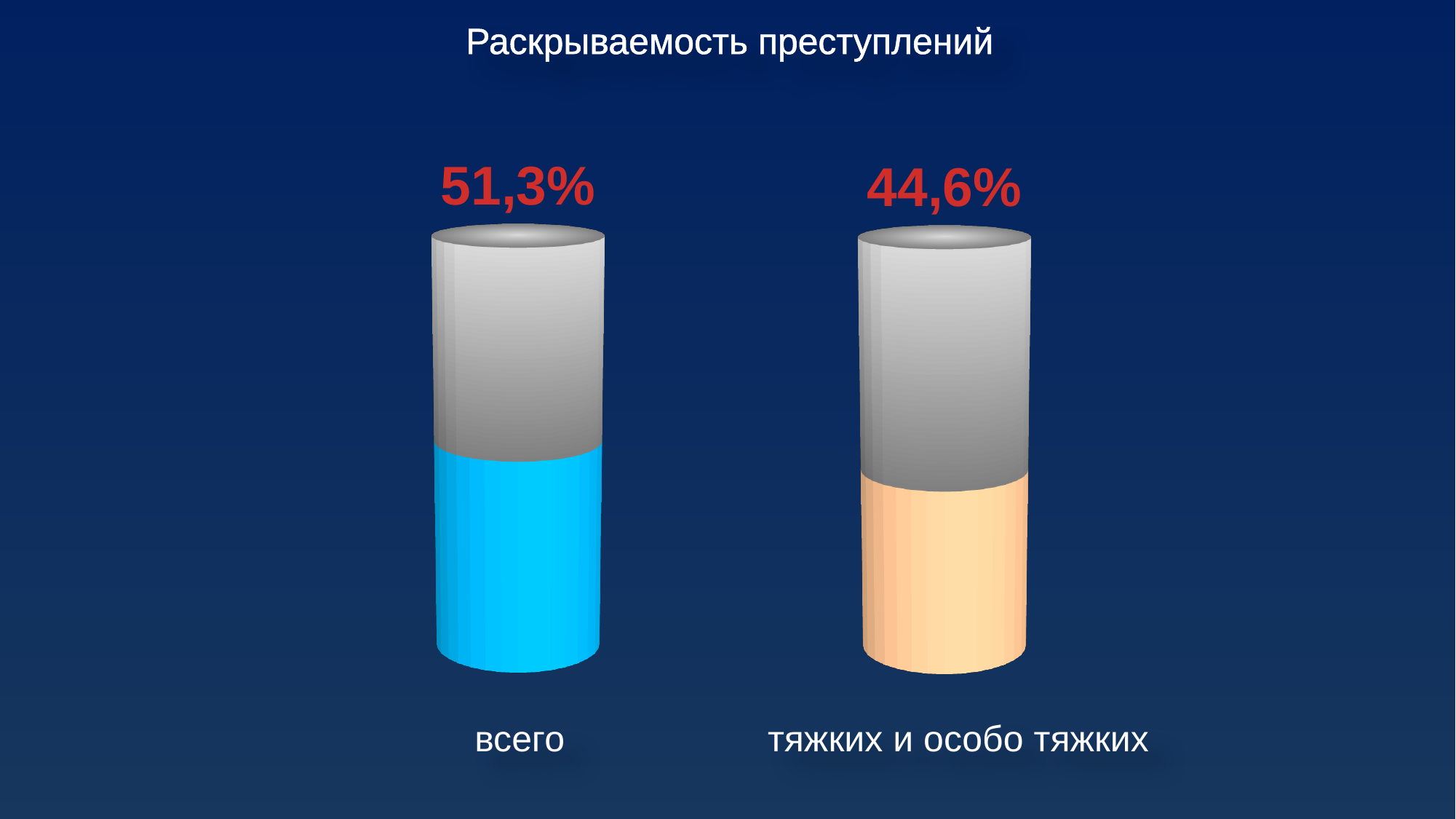
What colour is the filled portion of the bar for всего? blue What is the difference between the value for всего and the value for тяжких и особо тяжких? 6,7% Which is larger: the value for всего or the value for тяжких и особо тяжких? всего Is the value for тяжких и особо тяжких greater or less than 50%? less What is the value for тяжких и особо тяжких? 44,6% What kind of chart is shown on the slide? bar chart What is the value for всего? 51,3% What is the title of the chart? Раскрываемость преступлений Which category has the highest value? всего Which category has the lowest value? тяжких и особо тяжких How many categories are shown on the chart? 2